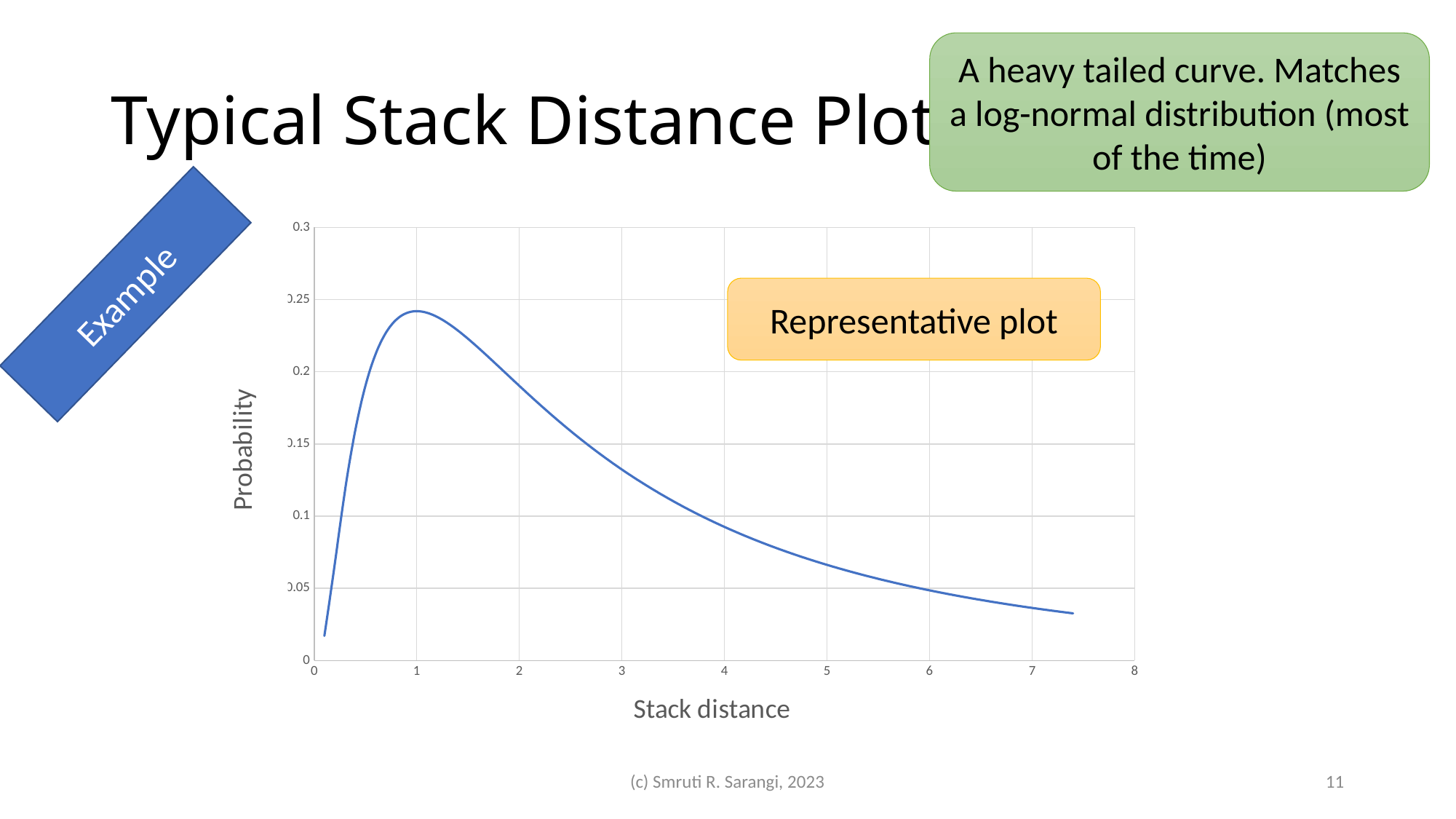
Does the probability rise or fall as stack distance increases from 2 to 7? fall Is the probability at stack distance 1 greater or less than 0.25? less What is the title of the y axis of the chart? Probability What kind of chart is shown on the slide? line chart What is the title of the x axis of the chart? Stack distance Is the probability at stack distance 3 greater or less than 0.15? less Which has the higher probability: stack distance 1 or stack distance 5? stack distance 1 Is the probability at stack distance 5 greater or less than 0.1? less